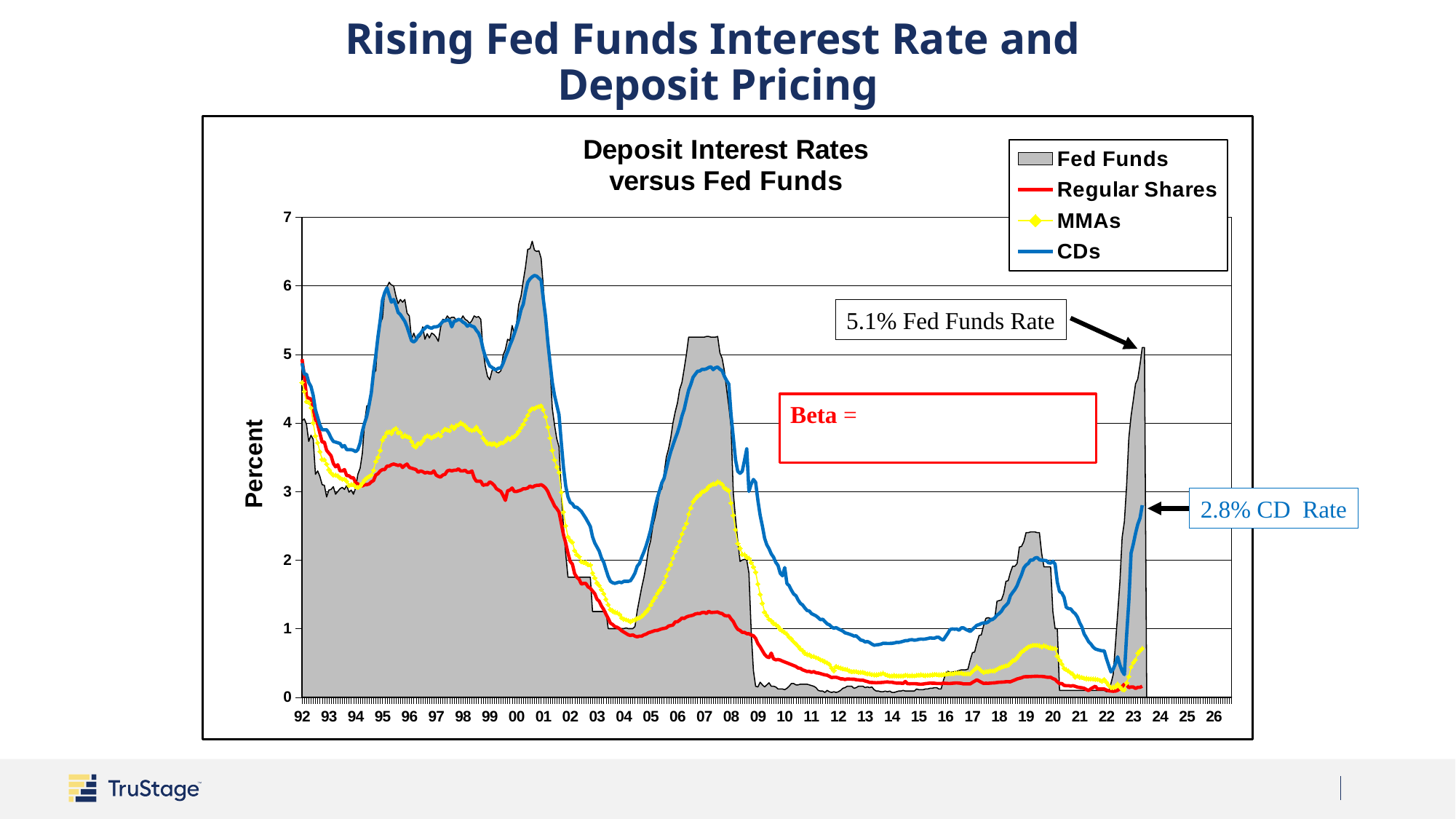
According to the annotation, what is the Fed Funds rate at the end of the series? 5.1% What is the title of the chart on the slide? Deposit Interest Rates versus Fed Funds What kind of chart is shown on the slide? combination area and line chart How many series does the chart's legend list? 4 What is the label on the vertical axis of the chart? Percent Around 2007, which series is higher: CDs or Regular Shares? CDs Is the value for CDs around 2007 greater or less than 4? greater Is the value for Regular Shares around 2013 greater or less than 1? less According to the annotation, what is the CD rate at the end of the series? 2.8% What is the difference between the annotated Fed Funds rate (5.1%) and the annotated CD rate (2.8%)? 2.3% At the end of the series, which is higher: the Fed Funds rate or the CD rate? Fed Funds rate